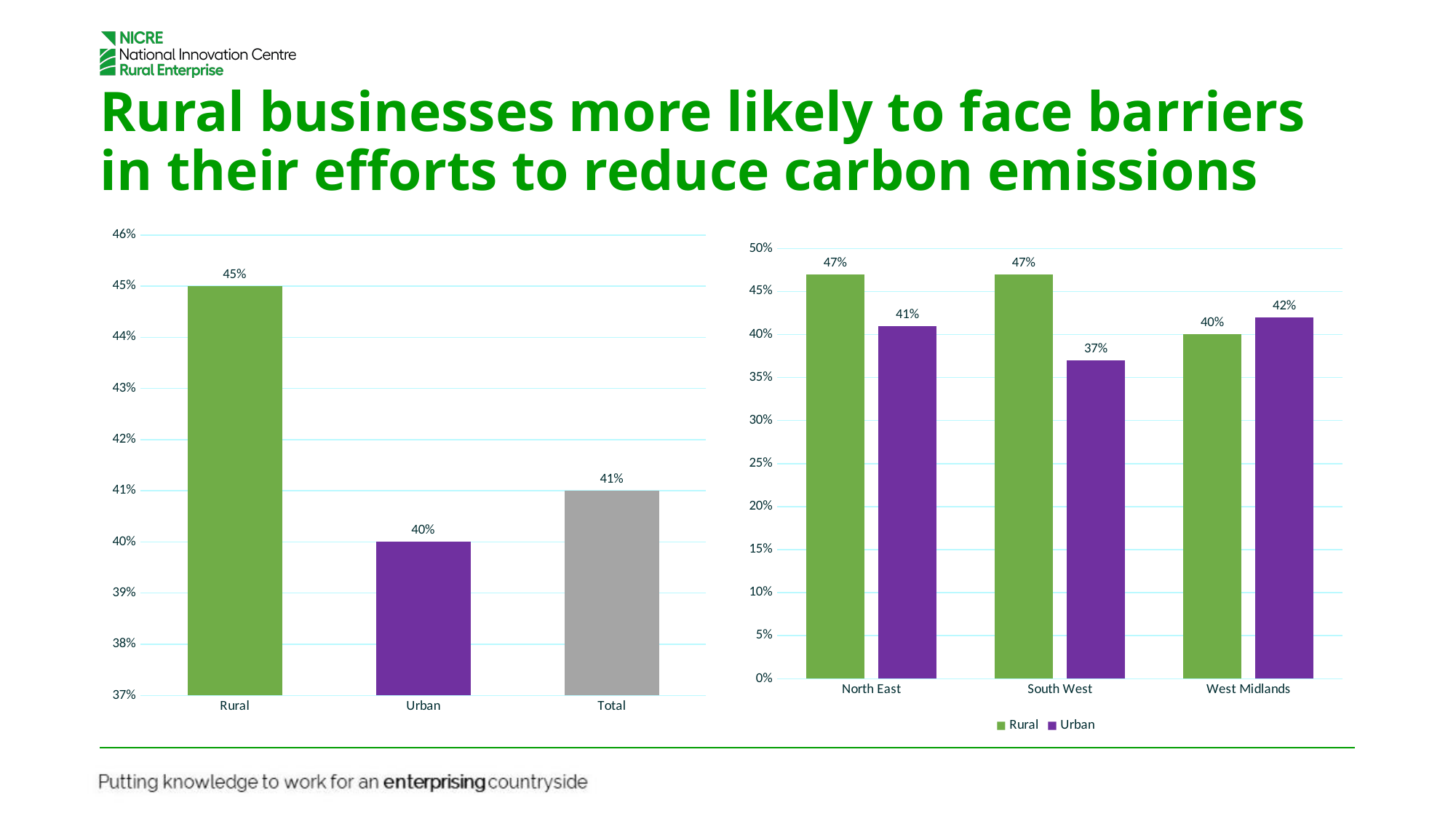
In the right chart, what is the Rural value for West Midlands? 40% In the right chart, what is the Urban value for South West? 37% In the left chart, how many categories are shown on the x axis? 3 In the right chart, what is the difference between the Rural and Urban values for South West? 10% In the left chart, what is the value for Rural? 45% In the right chart, which colour represents the Urban series? Purple In the left chart, what is the difference between the Rural and Urban values? 5% In the left chart, which category has the lowest value? Urban In the right chart, which is larger for West Midlands, Rural or Urban? Urban In the left chart, what is the value for Urban? 40% What kind of chart is the right chart? Bar chart In the right chart, how many series does the legend list? 2